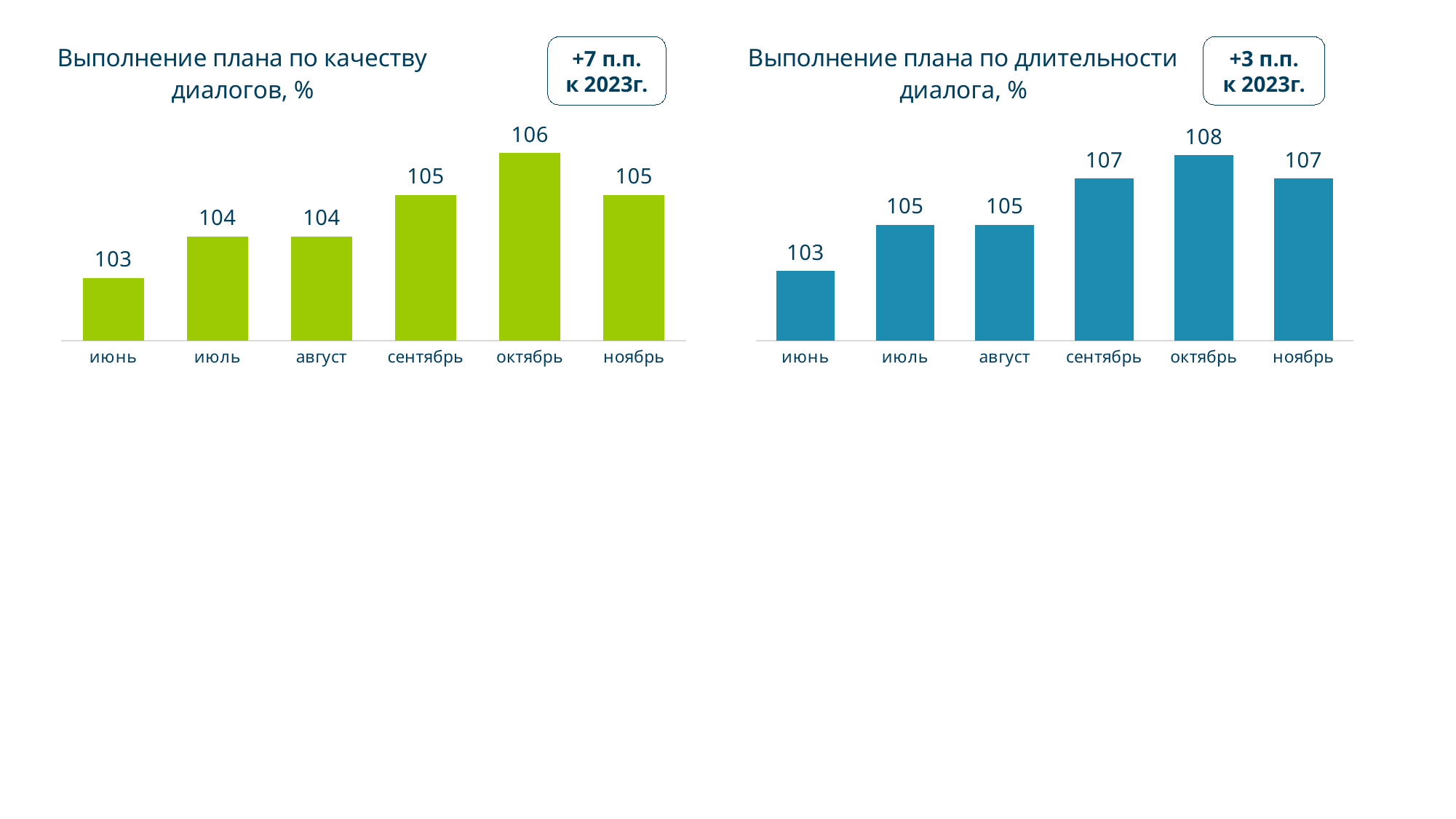
What change versus 2023 is shown in the callout box next to the left chart 'Выполнение плана по качеству диалогов, %'? +7 п.п. к 2023г. In the left chart 'Выполнение плана по качеству диалогов, %', what is the difference between the values for октябрь and июль? 2 In the right chart 'Выполнение плана по длительности диалога, %', what is the difference between the values for октябрь and июнь? 5 What type of chart is the right chart 'Выполнение плана по длительности диалога, %'? bar chart In the right chart 'Выполнение плана по длительности диалога, %', what is the value for сентябрь? 107 In the right chart 'Выполнение плана по длительности диалога, %', which is larger: the value for июль or the value for ноябрь? ноябрь In the left chart 'Выполнение плана по качеству диалогов, %', what is the value for июнь? 103 In the left chart 'Выполнение плана по качеству диалогов, %', which month has the lowest value? июнь In the right chart 'Выполнение плана по длительности диалога, %', which month has the highest value? октябрь In the left chart 'Выполнение плана по качеству диалогов, %', what is the value for октябрь? 106 How many months are shown on the x axis of the left chart 'Выполнение плана по качеству диалогов, %'? 6 In the right chart 'Выполнение плана по длительности диалога, %', do the values generally rise or fall from июнь to октябрь? rise